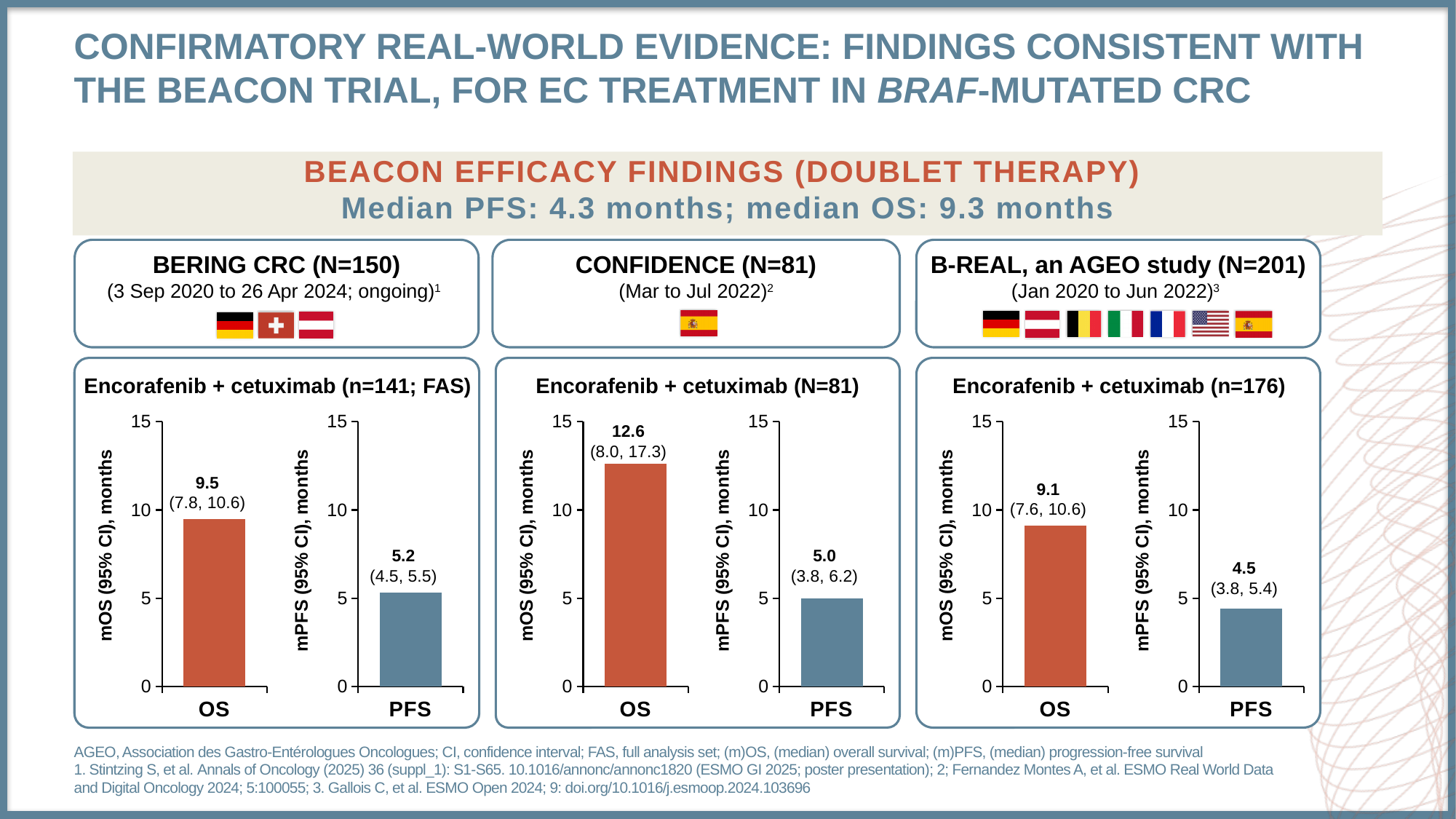
What type of chart is used to display the OS and PFS values in each panel? bar chart In the B-REAL panel, what is the median OS value shown? 9.1 In the CONFIDENCE panel, is the median OS bar greater or less than 10 on the axis? greater In the B-REAL panel, what is the 95% CI printed for the median PFS bar? (3.8, 5.4) Across the three study panels, which study shows the highest median OS? CONFIDENCE What is the maximum value shown on the y-axis of the OS and PFS charts? 15 In the CONFIDENCE panel, what is the median PFS value shown? 5.0 Which is larger: the median OS in BERING CRC or the median OS in B-REAL? BERING CRC (9.5) In the BERING CRC panel, what is the median OS value shown for encorafenib + cetuximab? 9.5 In the CONFIDENCE panel, what is the difference between the median OS and median PFS values? 7.6 What colour are the mOS bars in the three panels? orange-red Across the three study panels, which study shows the lowest median PFS? B-REAL